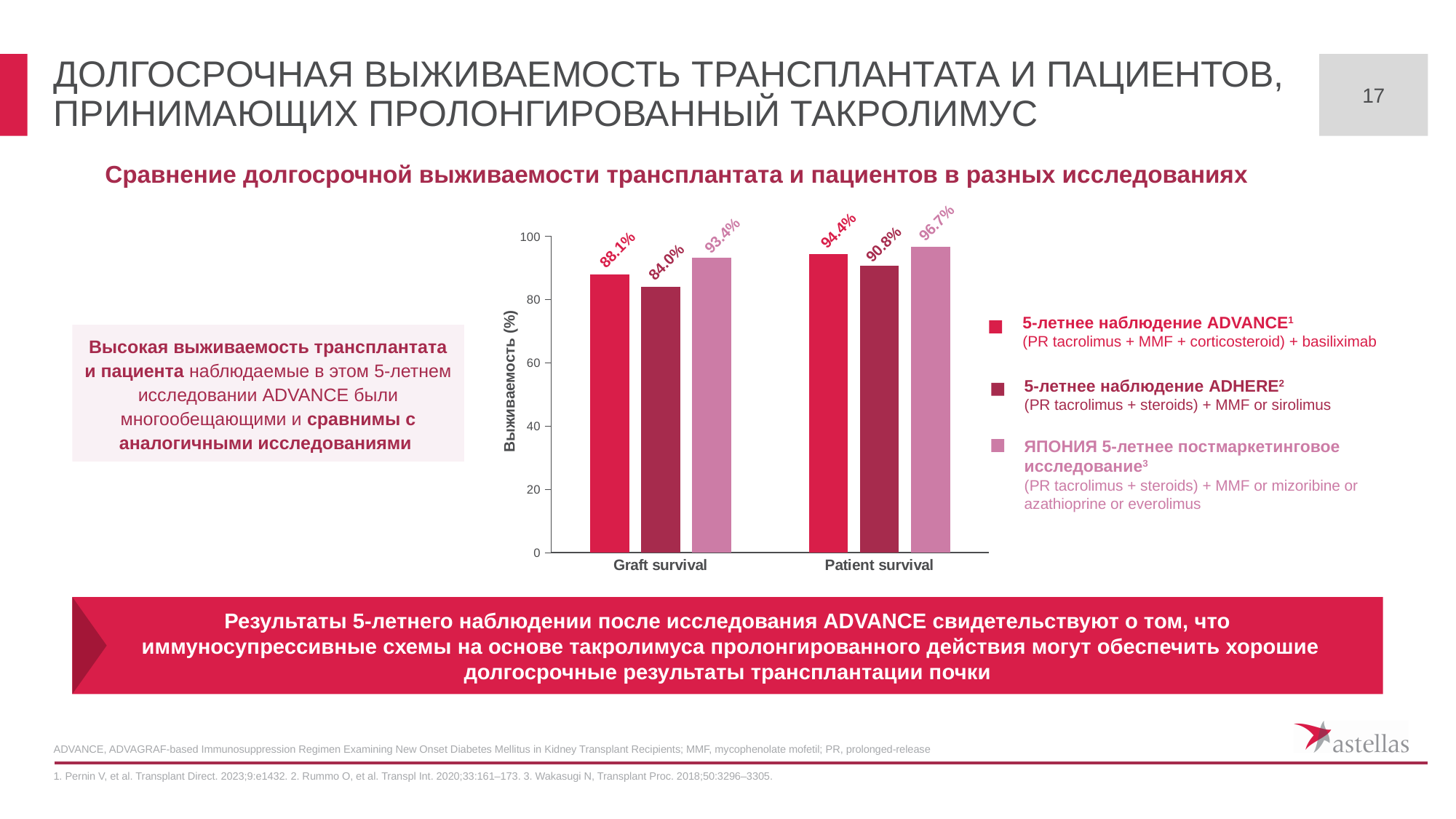
Which series has the lowest patient survival value? 5-летнее наблюдение ADHERE Which is larger: the ADVANCE graft survival value or the ADHERE graft survival value? ADVANCE graft survival What is the difference between the Japan study and ADHERE graft survival values? 9.4% What is the patient survival value for the 5-летнее наблюдение ADHERE series? 90.8% What is the graft survival value for the 5-летнее наблюдение ADVANCE series? 88.1% Which series has the highest graft survival value? ЯПОНИЯ 5-летнее постмаркетинговое исследование How many categories are shown on the x axis? 2 What kind of chart is shown on the slide? Bar chart Is the ADHERE graft survival value greater or less than 80? greater How many series does the legend list? 3 What is the difference between the patient survival and graft survival values for the ADVANCE series? 6.3% What is the patient survival value for the ЯПОНИЯ 5-летнее постмаркетинговое исследование series? 96.7%